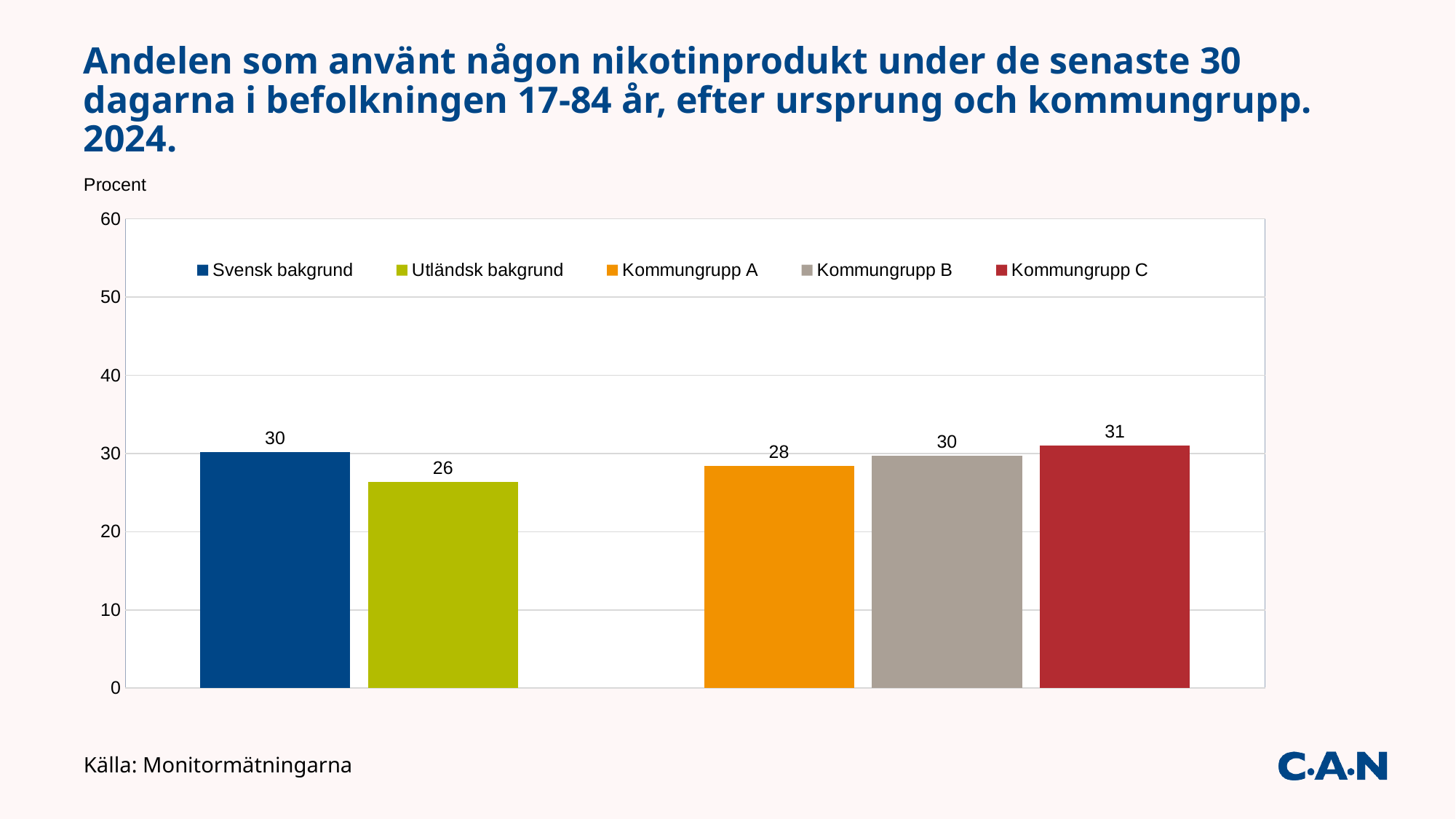
What is the value for Kommungrupp C? 31 What is the value for Kommungrupp A? 28 Is the value for Kommungrupp C greater or less than 40? less What is the value for Utländsk bakgrund? 26 Which group has the highest value? Kommungrupp C Which is larger, the value for Kommungrupp A or the value for Kommungrupp B? Kommungrupp B How many bars are plotted in the chart? 5 What is the difference between the values for Svensk bakgrund and Utländsk bakgrund? 4 How many series does the legend list? 5 Which group has the lowest value? Utländsk bakgrund What kind of chart is shown on the slide? bar chart What is the value for Svensk bakgrund? 30